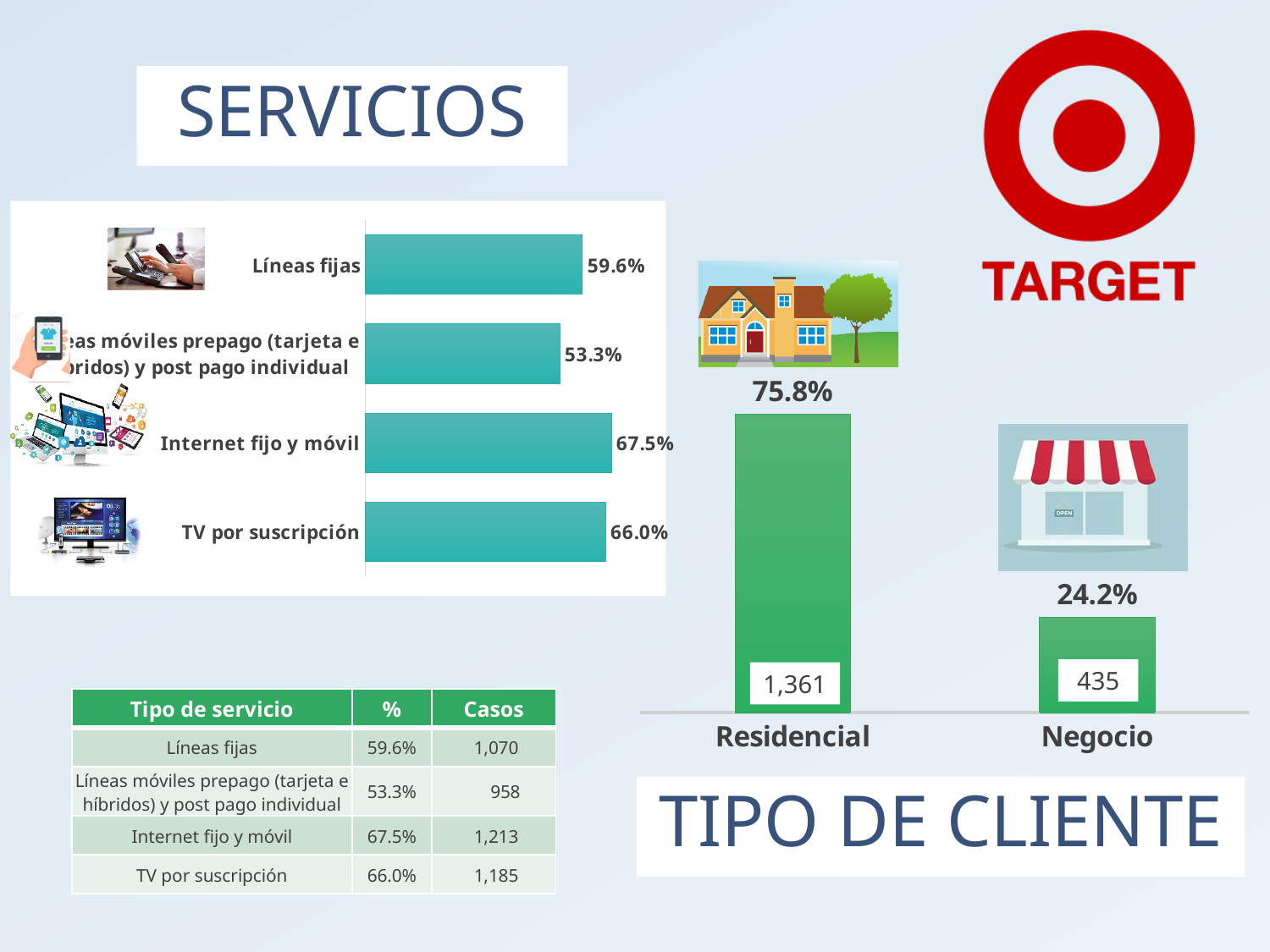
What kind of chart is the SERVICIOS chart? Bar chart In the SERVICIOS chart, which category has the highest value? Internet fijo y móvil How many categories does the SERVICIOS chart show? 4 In the TIPO DE CLIENTE chart, which category has the lowest value? Negocio In the SERVICIOS chart, which is larger, Líneas fijas or TV por suscripción? TV por suscripción In the TIPO DE CLIENTE chart, what is the difference in cases between Residencial and Negocio? 926 In the SERVICIOS chart, what is the difference between Internet fijo y móvil and TV por suscripción? 1.5 percentage points In the TIPO DE CLIENTE chart, what percentage is shown for Residencial? 75.8% In the TIPO DE CLIENTE chart, how many cases are shown for Negocio? 435 In the SERVICIOS chart, what is the value for Internet fijo y móvil? 67.5% In the SERVICIOS chart, what is the value for TV por suscripción? 66.0% In the SERVICIOS chart, which category has the lowest value? Líneas móviles prepago (tarjeta e híbridos) y post pago individual